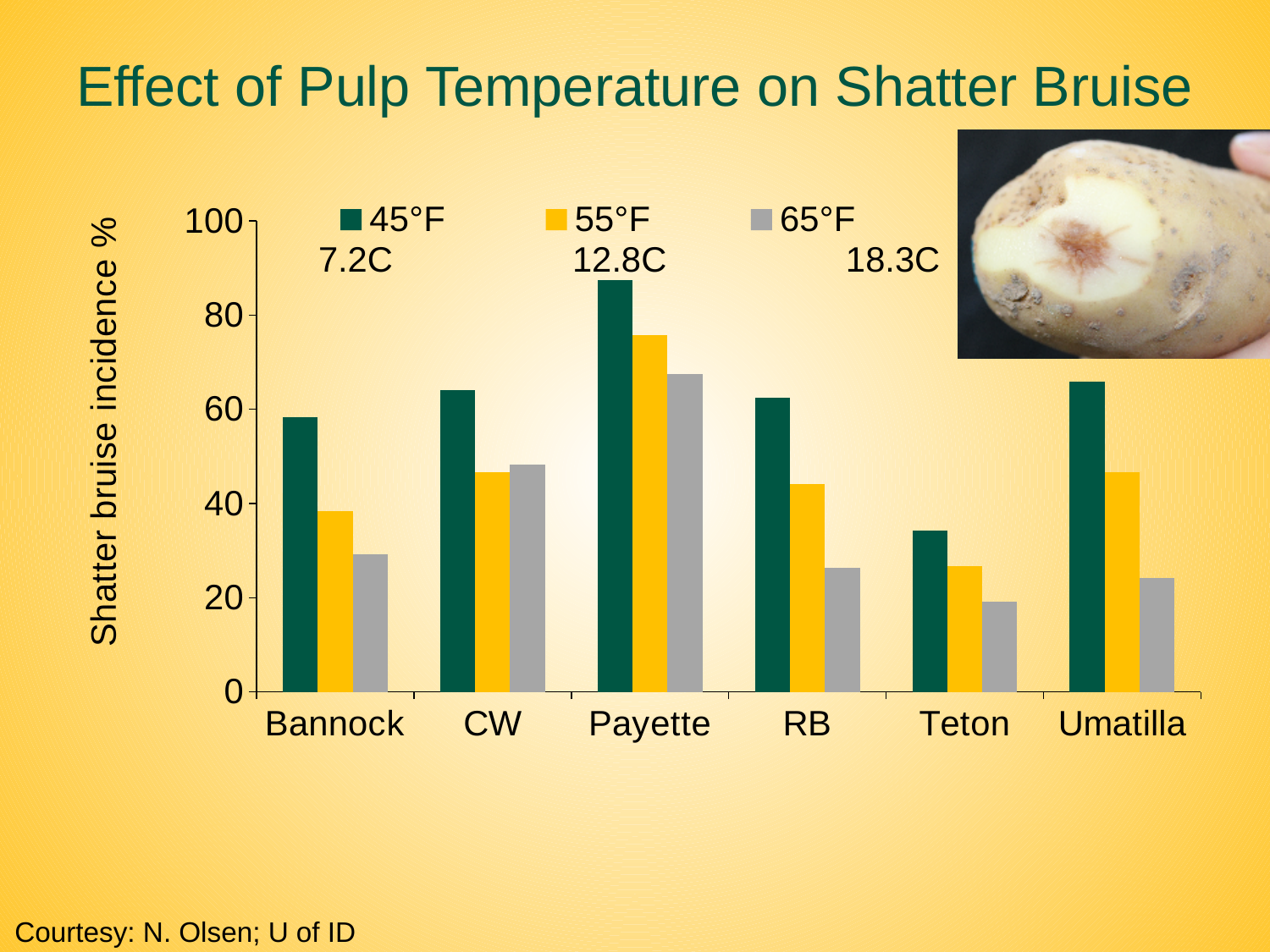
Which variety has the lowest shatter bruise incidence at 45°F? Teton What is the label on the y axis? Shatter bruise incidence % Is the 45°F value for Teton greater or less than 40? less Is the 55°F value for Payette greater or less than 60? greater Which is larger, the 55°F value for RB or the 55°F value for Teton? RB How many series does the legend list? 3 Which variety has the highest shatter bruise incidence at 45°F? Payette Which is larger, the 45°F value for Bannock or the 45°F value for Umatilla? Umatilla What kind of chart is shown on the slide? Bar chart How many potato varieties are shown on the x axis? 6 Is the 45°F value for Payette greater or less than 80? greater Which variety has the highest shatter bruise incidence at 65°F? Payette